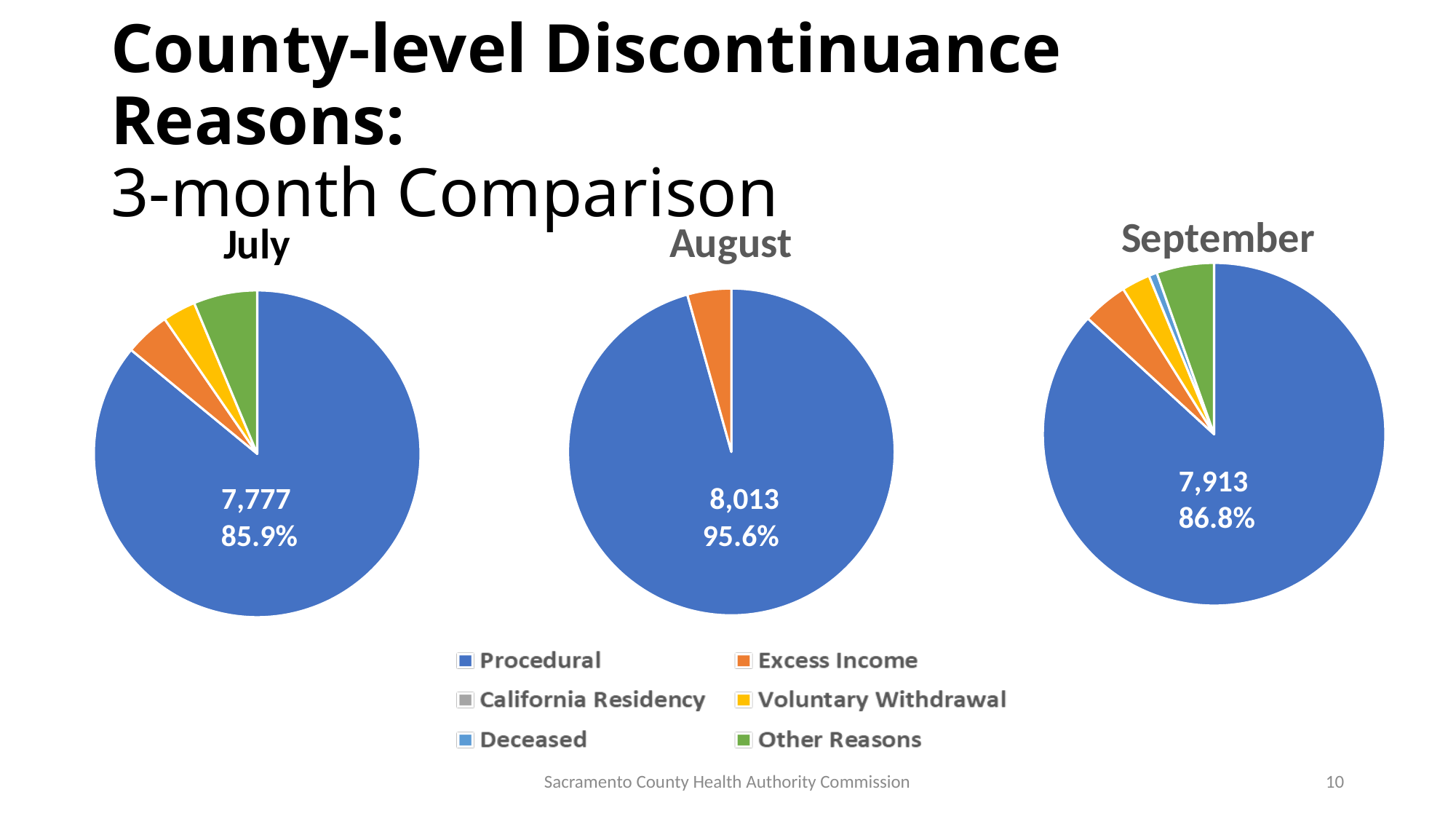
In the September pie chart, what percentage share does the Procedural slice have? 86.8% In the July pie chart, what value is shown for the Procedural slice? 7,777 Which month's pie chart shows the highest Procedural count? August In the September pie chart, what value is shown for the Procedural slice? 7,913 What is the difference between the Procedural counts in the August and July pie charts? 236 In the August pie chart, what percentage share does the Procedural slice have? 95.6% In the August pie chart, what value is shown for the Procedural slice? 8,013 In the July pie chart, what percentage share does the Procedural slice have? 85.9% What kind of chart is used for the July, August and September data on this slide? Pie chart Which month's pie chart shows the lowest Procedural count? July Is the Procedural share larger in the September pie chart or the July pie chart? September How many categories does the shared legend list for the pie charts? 6